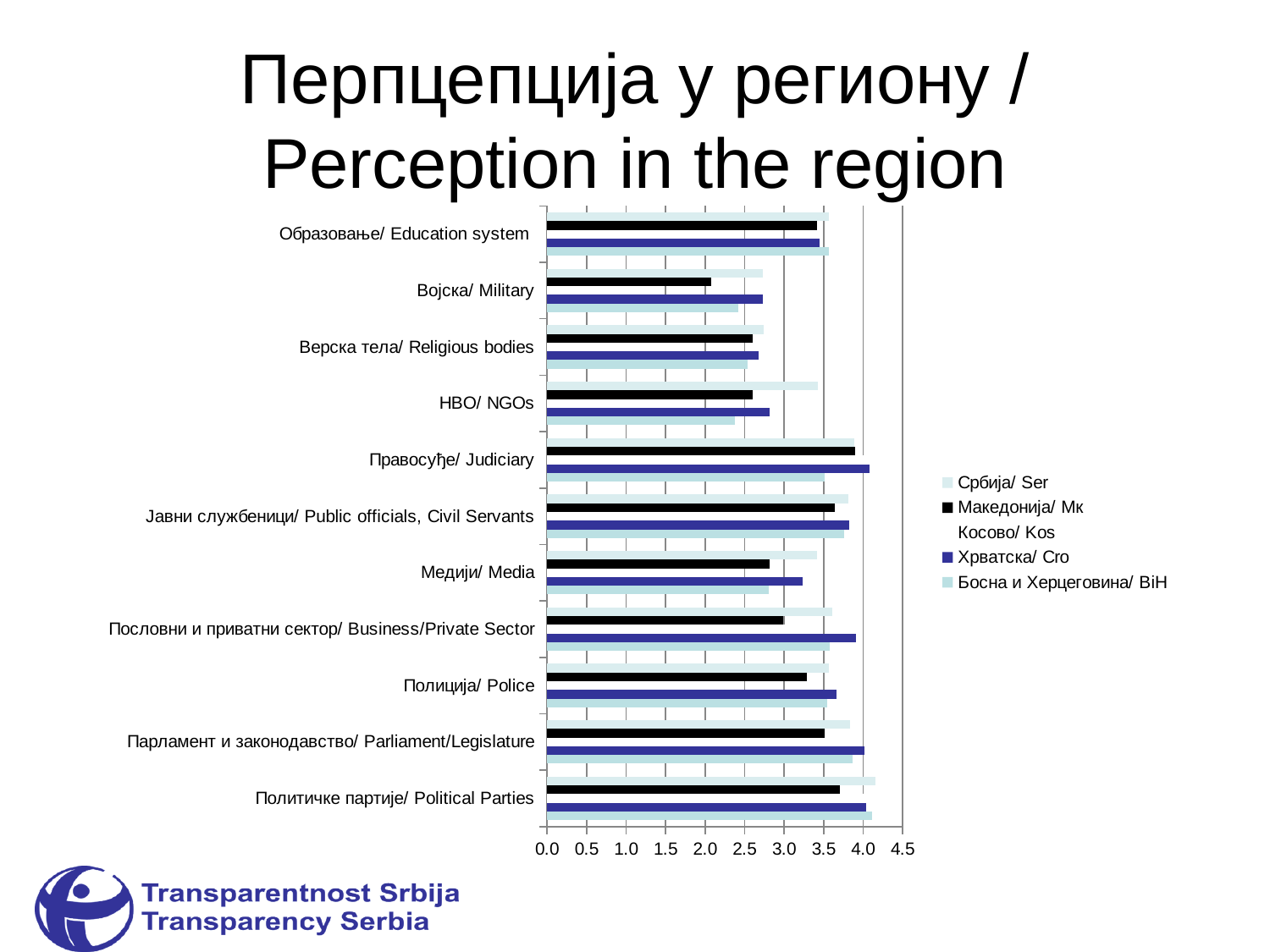
Which series is listed first in the chart legend? Србија/Ser In the Војска/Military category, which is larger: the value for Србија/Ser or for Македонија/Мк? Србија/Ser Is the value for Хрватска/Cro in the Правосуђе/Judiciary category greater or less than 3.5? greater In the Пословни и приватни сектор/Business/Private Sector category, which is larger: the value for Хрватска/Cro or for Македонија/Мк? Хрватска/Cro What kind of chart is shown on the slide? Bar chart Is the value for Македонија/Мк in the Медији/Media category greater or less than 3.0? less Is the value for Македонија/Мк in the Војска/Military category greater or less than 2.5? less What is the English part of the slide title? Perception in the region For the Македонија/Мк series, which category has the lowest value? Војска/Military How many categories (institutions) are listed on the vertical axis of the chart? 11 How many series does the chart legend list? 5